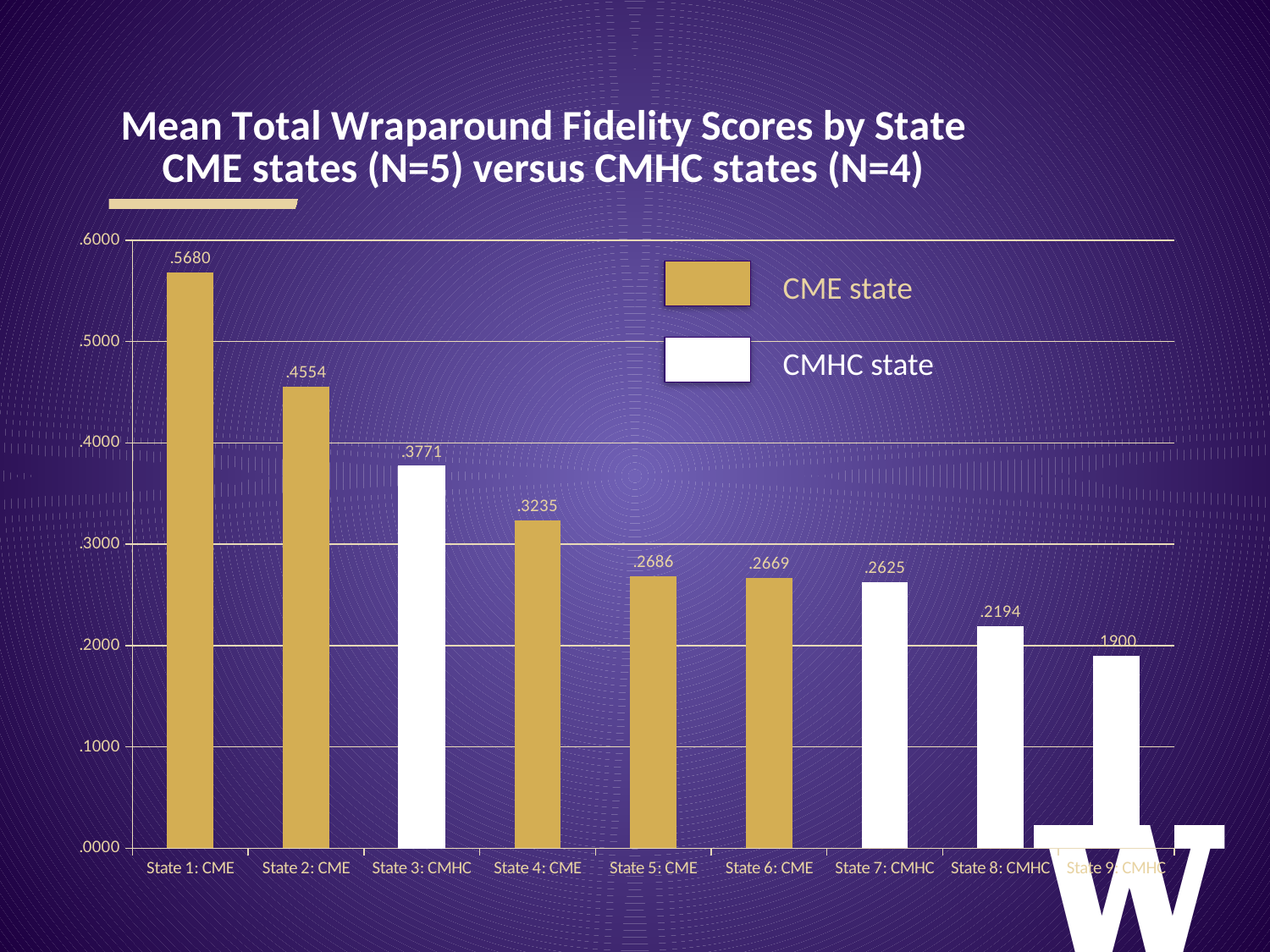
What is the value shown for State 3: CMHC? .3771 What is the difference between the scores for State 1: CME and State 2: CME? .1126 Which state has the highest mean total wraparound fidelity score? State 1: CME What kind of chart is shown on the slide? Bar chart What is the mean total wraparound fidelity score for State 1: CME? .5680 How many series does the legend list? 2 Which state has the lowest mean total wraparound fidelity score? State 9: CMHC How many states are shown on the x axis of the chart? 9 Do the values rise or fall from State 1 to State 9 along the x axis? Fall Which has a higher score, State 4: CME or State 8: CMHC? State 4: CME What is the value shown for State 7: CMHC? .2625 Is the value for State 2: CME greater or less than .4000? greater